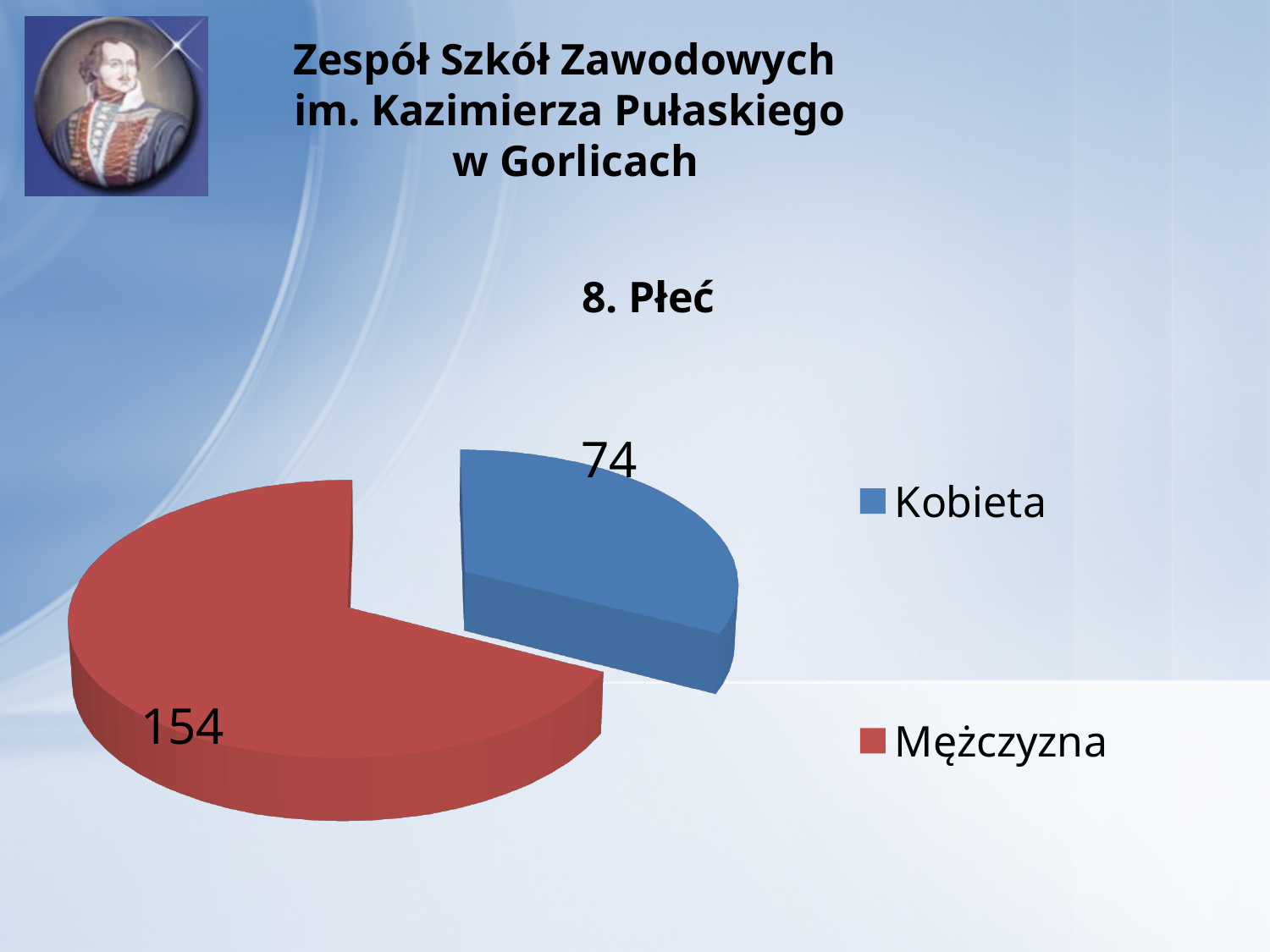
How many categories does the pie chart show? 2 What value is shown for Mężczyzna in the pie chart? 154 Which is larger, the value for Kobieta or the value for Mężczyzna? Mężczyzna Which category has the largest slice in the pie chart? Mężczyzna What kind of chart is shown on the slide? Pie chart What is the title of the chart? 8. Płeć What colour is the Kobieta slice in the pie chart? Blue What is the total of the two values shown in the pie chart? 228 What is the difference between the values for Mężczyzna and Kobieta? 80 Which category has the smallest slice in the pie chart? Kobieta What value is shown for Kobieta in the pie chart? 74